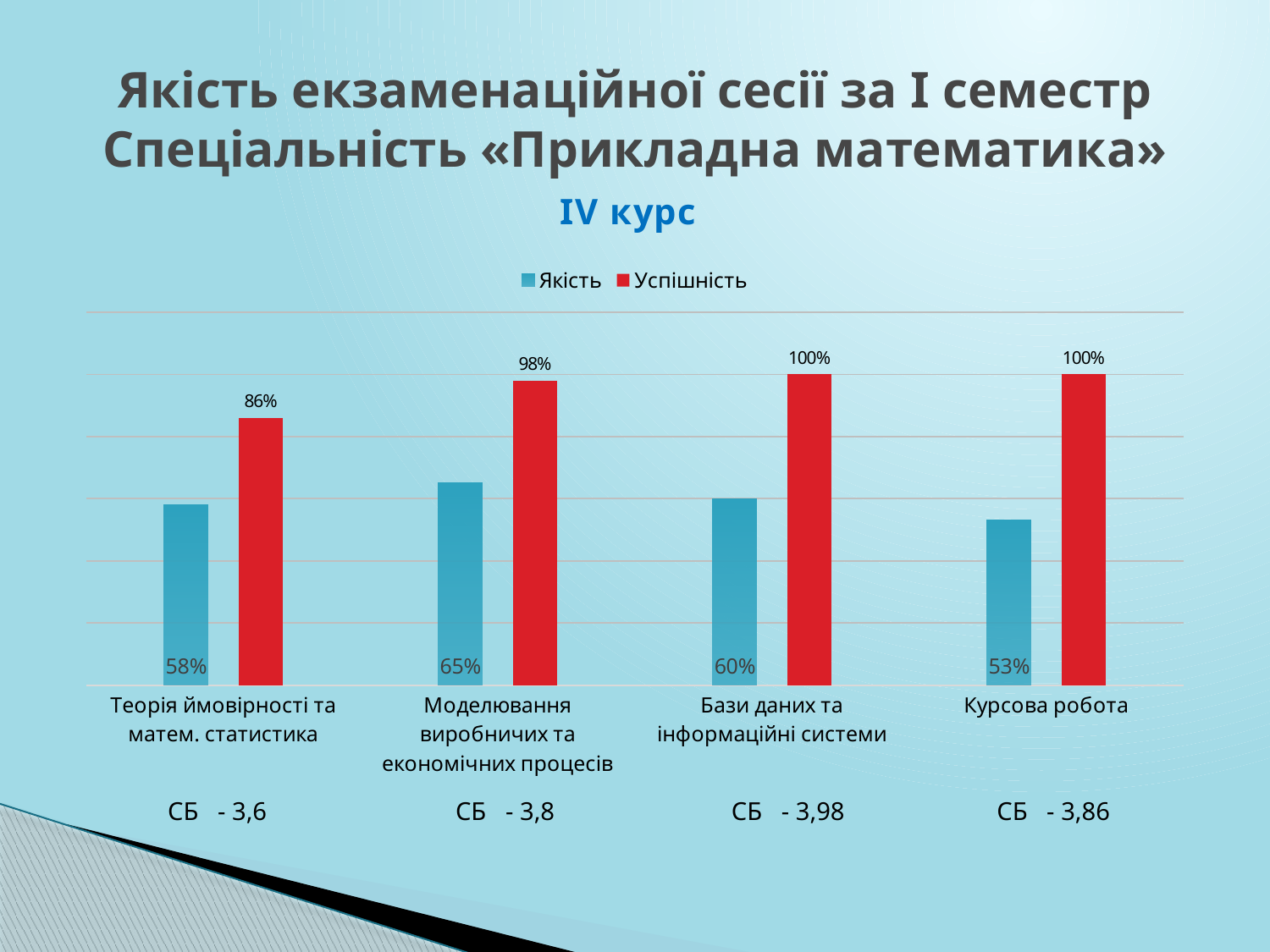
What is the Якість value for Курсова робота? 53% What kind of chart is shown on the slide? Bar chart Which category has the lowest Якість value? Курсова робота What is the Якість value for Моделювання виробничих та економічних процесів? 65% Which category has the highest Якість value? Моделювання виробничих та економічних процесів How many categories are shown on the x axis? 4 Which is larger: the Якість value for Бази даних та інформаційні системи or the Якість value for Курсова робота? Бази даних та інформаційні системи What is the Успішність value for Бази даних та інформаційні системи? 100% What is the difference between the Успішність and Якість values for Теорія ймовірності та матем. статистика? 28% What is the Успішність value for Теорія ймовірності та матем. статистика? 86% Which category has the lowest Успішність value? Теорія ймовірності та матем. статистика How many series does the legend list? 2